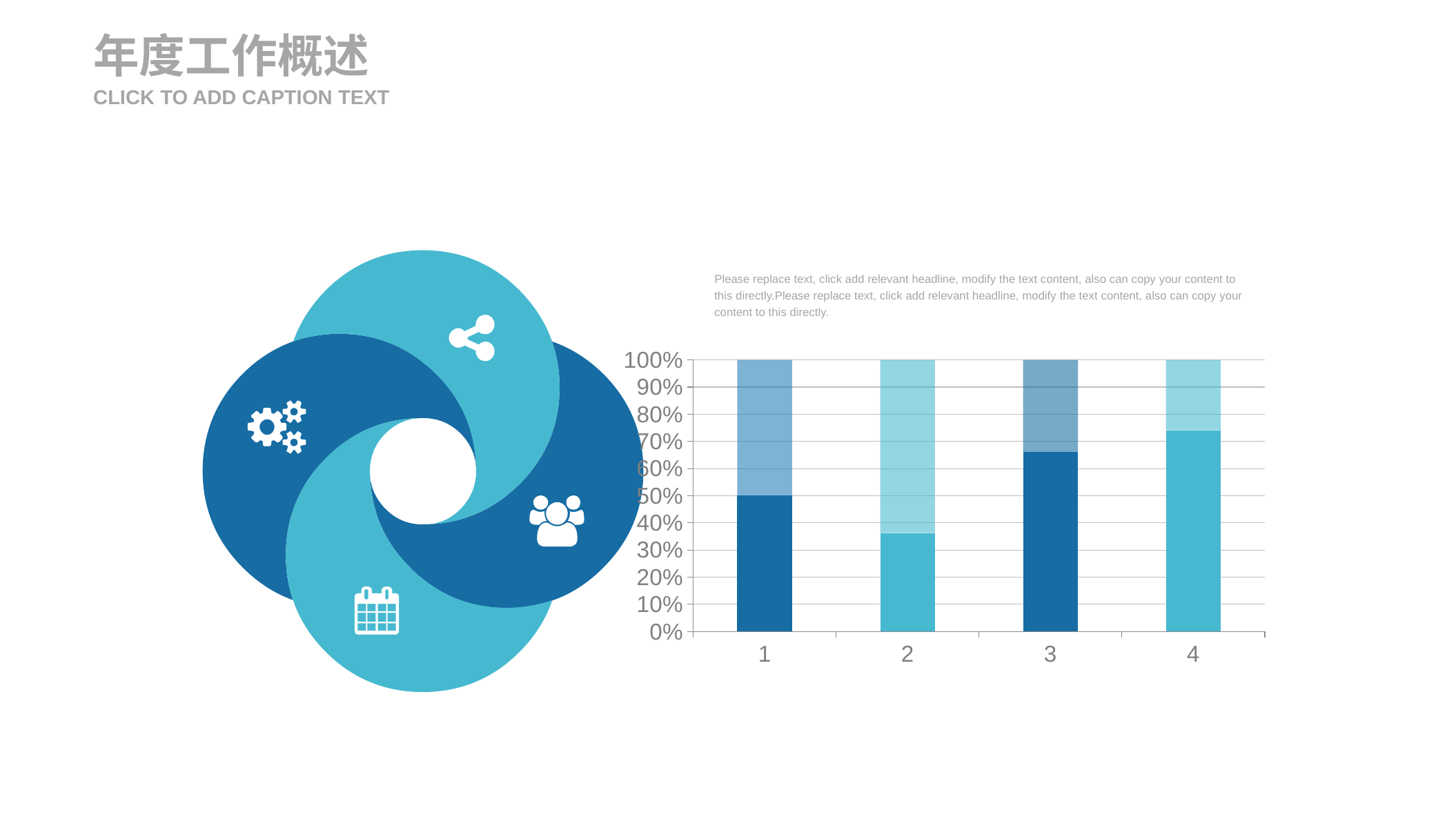
Which category has the smallest bottom segment? 2 Is the bottom segment of bar 4 greater or less than 70%? greater What value does the bottom (dark) segment of bar 1 reach on the y axis? 50% Is the bottom segment of bar 3 greater or less than 60%? greater How many categories are shown on the x axis of the chart? 4 Is the bottom segment of bar 2 greater or less than 30%? greater Which has a larger bottom segment, bar 1 or bar 3? 3 What is the maximum value shown on the y axis of the chart? 100% Which category has the largest bottom segment? 4 What kind of chart is shown on the slide? stacked bar chart